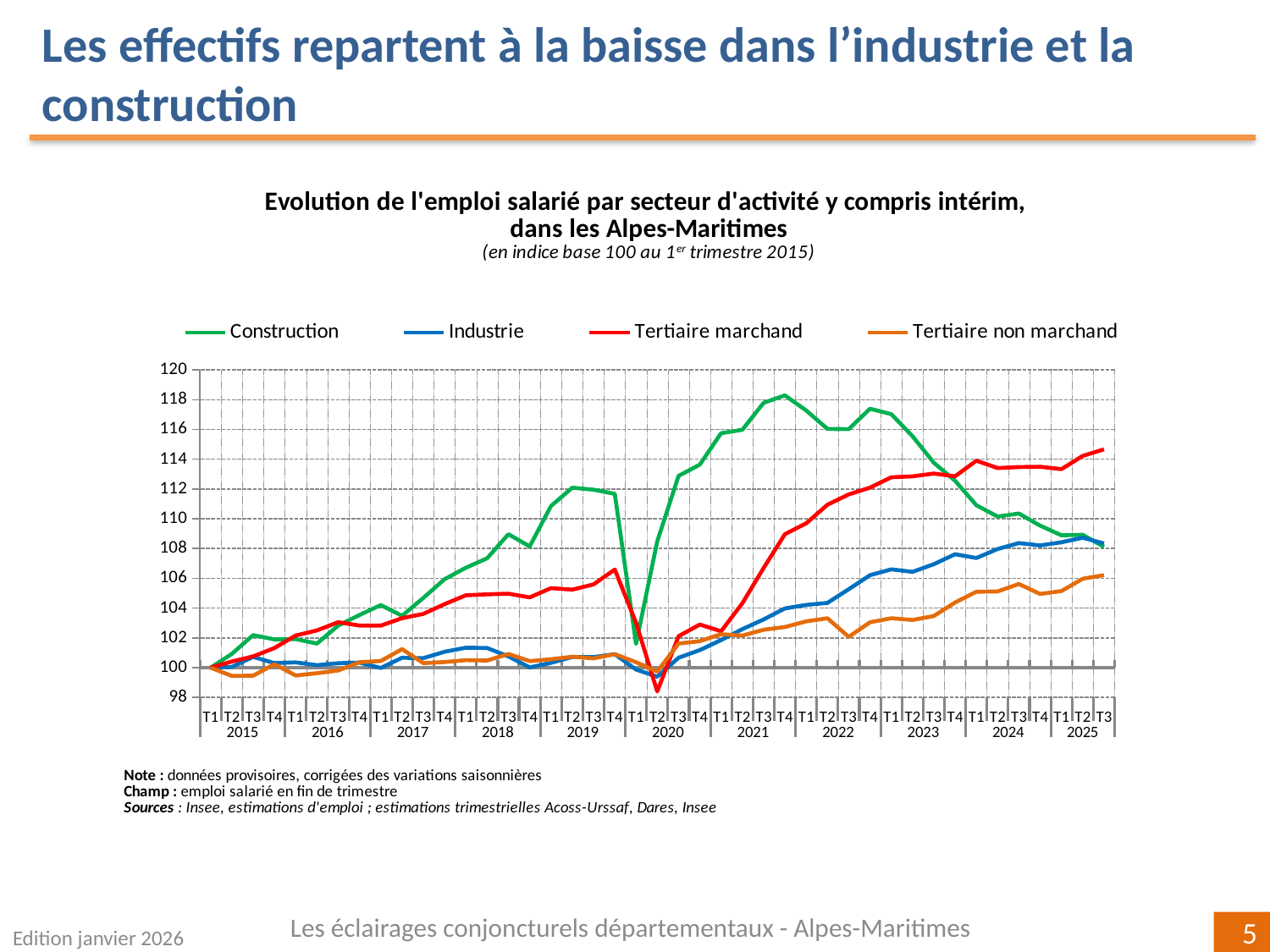
How many years are labelled along the x axis? 11 At T4 2021, which is larger: Construction or Tertiaire marchand? Construction Does the Construction series rise or fall between T1 2023 and T3 2025? fall What is the index value of all four series at T1 2015? 100 Which colour is used for the Industrie series? blue Is the value for Construction at T4 2021 greater or less than 116? greater Is the value for Tertiaire marchand at T2 2020 greater or less than 100? less Which series reaches the highest index value anywhere on the chart? Construction Which series has the highest value at T3 2025? Tertiaire marchand What kind of chart is shown on the slide? line chart How many series does the legend list? 4 Which series has the lowest value at T3 2025? Tertiaire non marchand